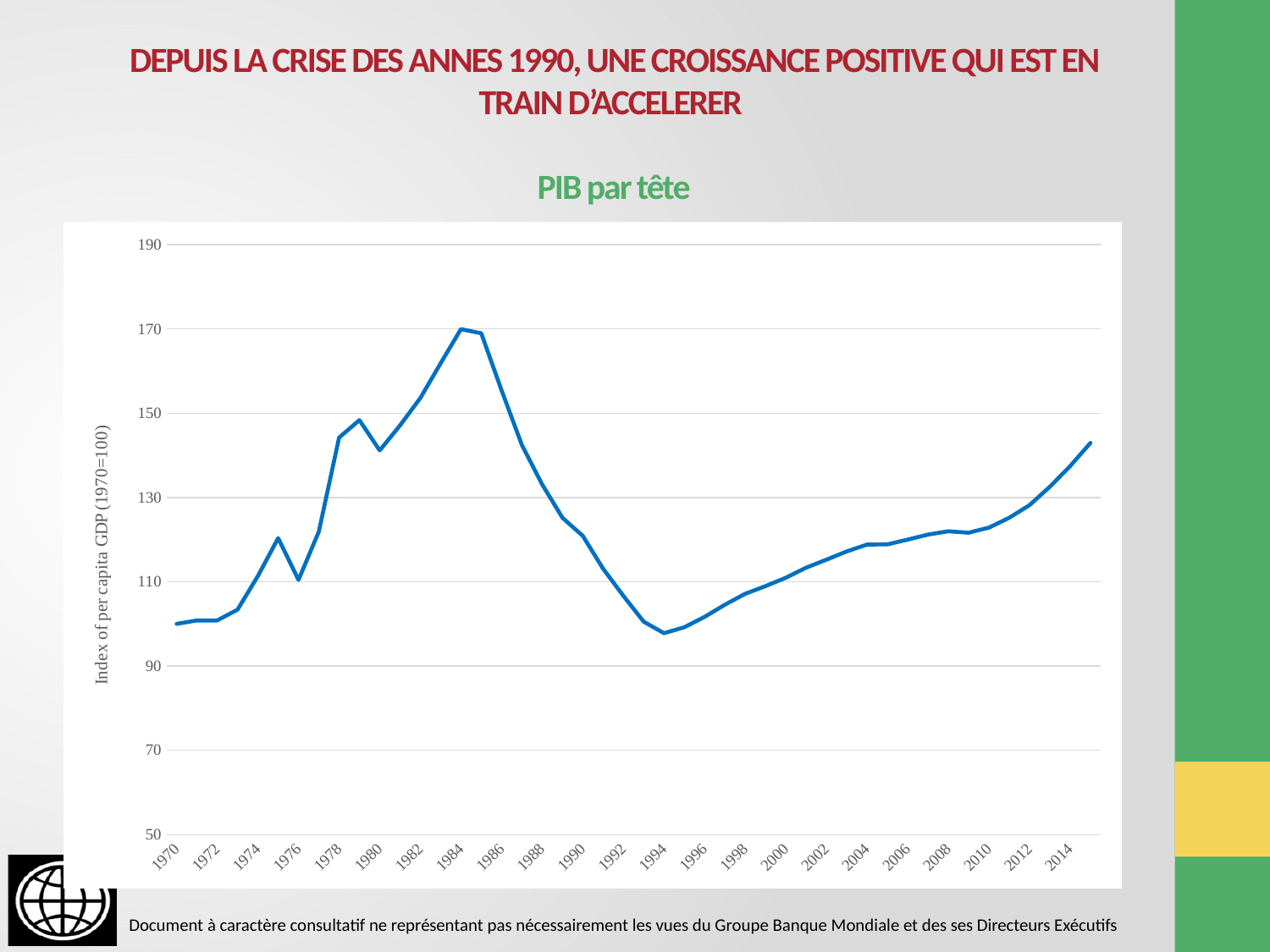
Is the value for 1994 greater or less than 110? less Is the value for 2014 greater or less than 130? greater In which year does the index reach its highest value? 1984 What is the label of the vertical axis? Index of per capita GDP (1970=100) Is the value for 1984 greater or less than 150? greater Which year has the higher value, 1978 or 1990? 1978 Does the index rise or fall between 1994 and 2014? rise What kind of chart is shown on the slide? line chart What is the title of the chart? PIB par tête What is the index value for 1970? 100 Which year has the higher value, 1984 or 2014? 1984